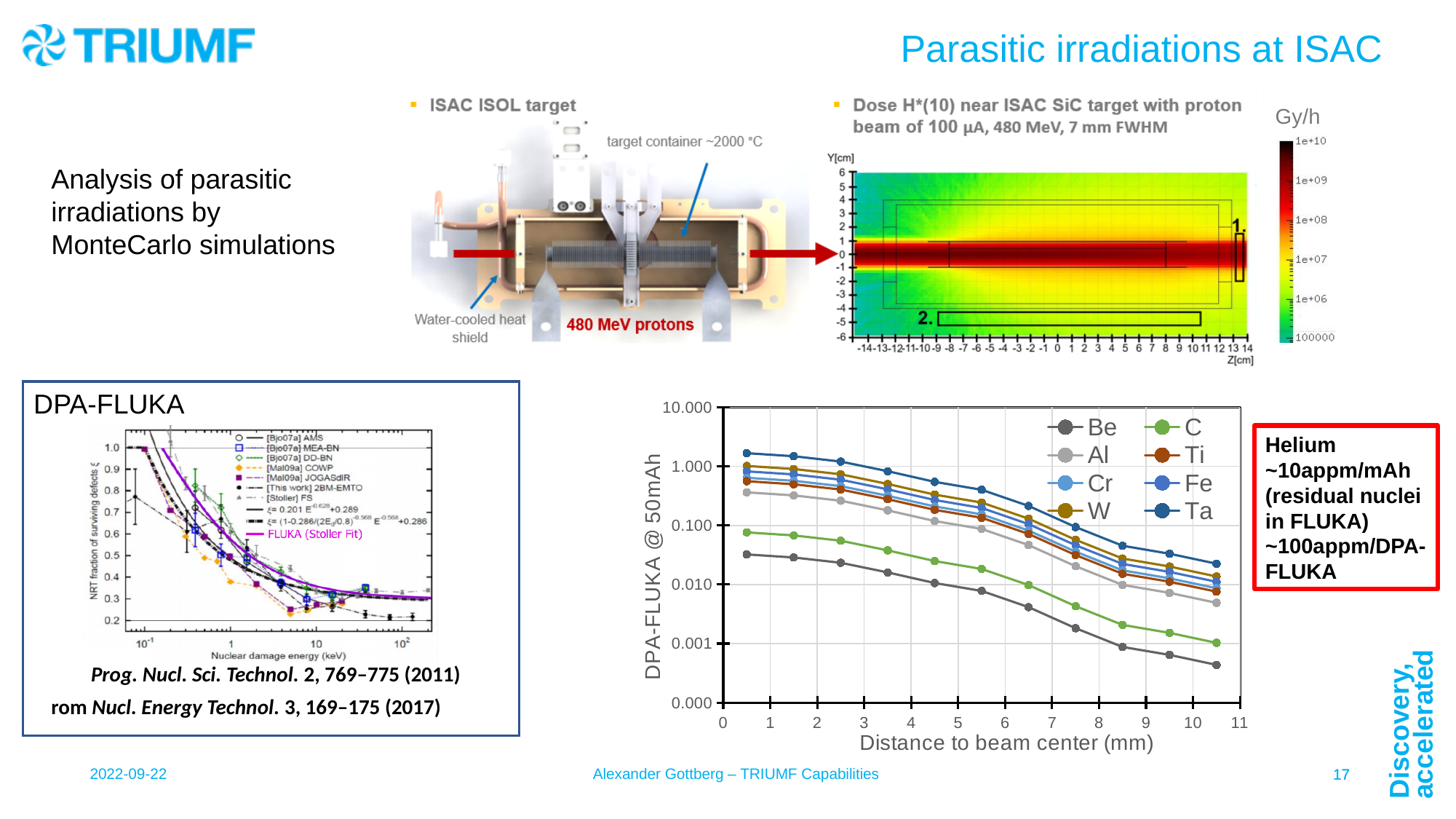
What kind of chart is the DPA-FLUKA @ 50mAh chart on the lower right of the slide? line chart How many series does the legend of the DPA-FLUKA @ 50mAh chart list? 8 In the DPA-FLUKA @ 50mAh chart, which series has the lowest values across the distance range? Be In the DPA-FLUKA @ 50mAh chart, do the values rise or fall as the distance to beam center increases? fall In the DPA-FLUKA @ 50mAh chart, which is larger at a distance of 5.5 mm, the value for Ta or the value for Be? Ta In the DPA-FLUKA @ 50mAh chart, which series has the highest values across the distance range? Ta In the DPA-FLUKA @ 50mAh chart, how many data points are plotted for the Ta series? 11 What unit is shown on the colour scale of the dose map near the ISAC SiC target? Gy/h What is the x-axis title of the DPA-FLUKA @ 50mAh chart? Distance to beam center (mm) In the DPA-FLUKA @ 50mAh chart, is the value for Ta at a distance of 0.5 mm greater or less than 1.000? greater In the DPA-FLUKA @ 50mAh chart, is the value for C at a distance of 0.5 mm greater or less than 0.100? less In the DPA-FLUKA @ 50mAh chart, is the value for Be at a distance of 10.5 mm greater or less than 0.001? less